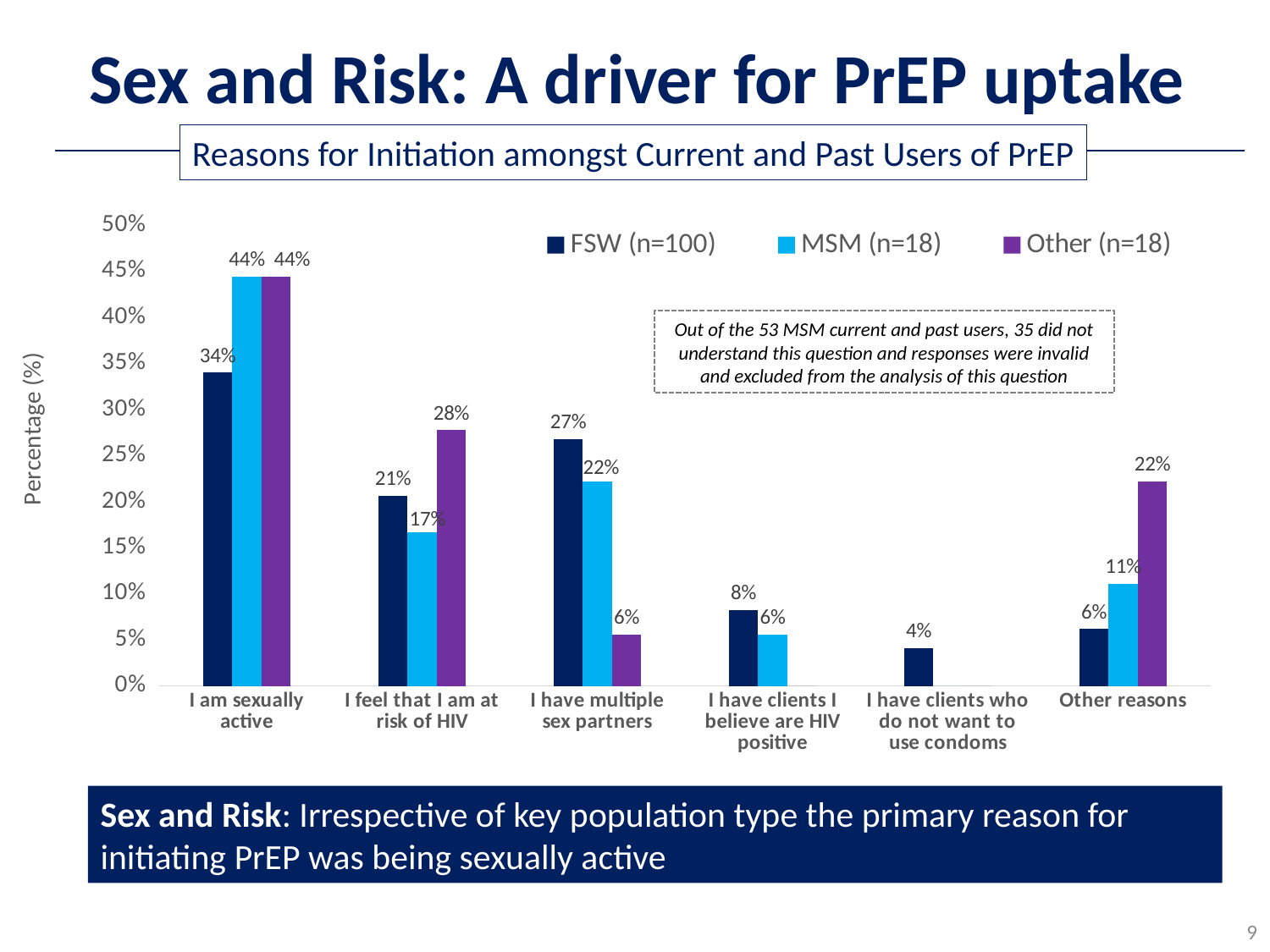
What percentage of FSW gave 'I have clients who do not want to use condoms' as a reason? 4% How many reason categories are shown on the x axis? 6 What is the sample size for the FSW group shown in the legend? n=100 How many series does the legend list? 3 What is the difference between the FSW and MSM percentages for 'I have multiple sex partners'? 5% For 'I feel that I am at risk of HIV', which group has the larger percentage, FSW or MSM? FSW What percentage of FSW gave 'I am sexually active' as a reason for initiation? 34% What percentage of the Other group gave 'I feel that I am at risk of HIV' as a reason? 28% What percentage of MSM gave 'Other reasons'? 11% Which reason has the highest percentage for FSW? I am sexually active What kind of chart is shown on the slide? Bar chart